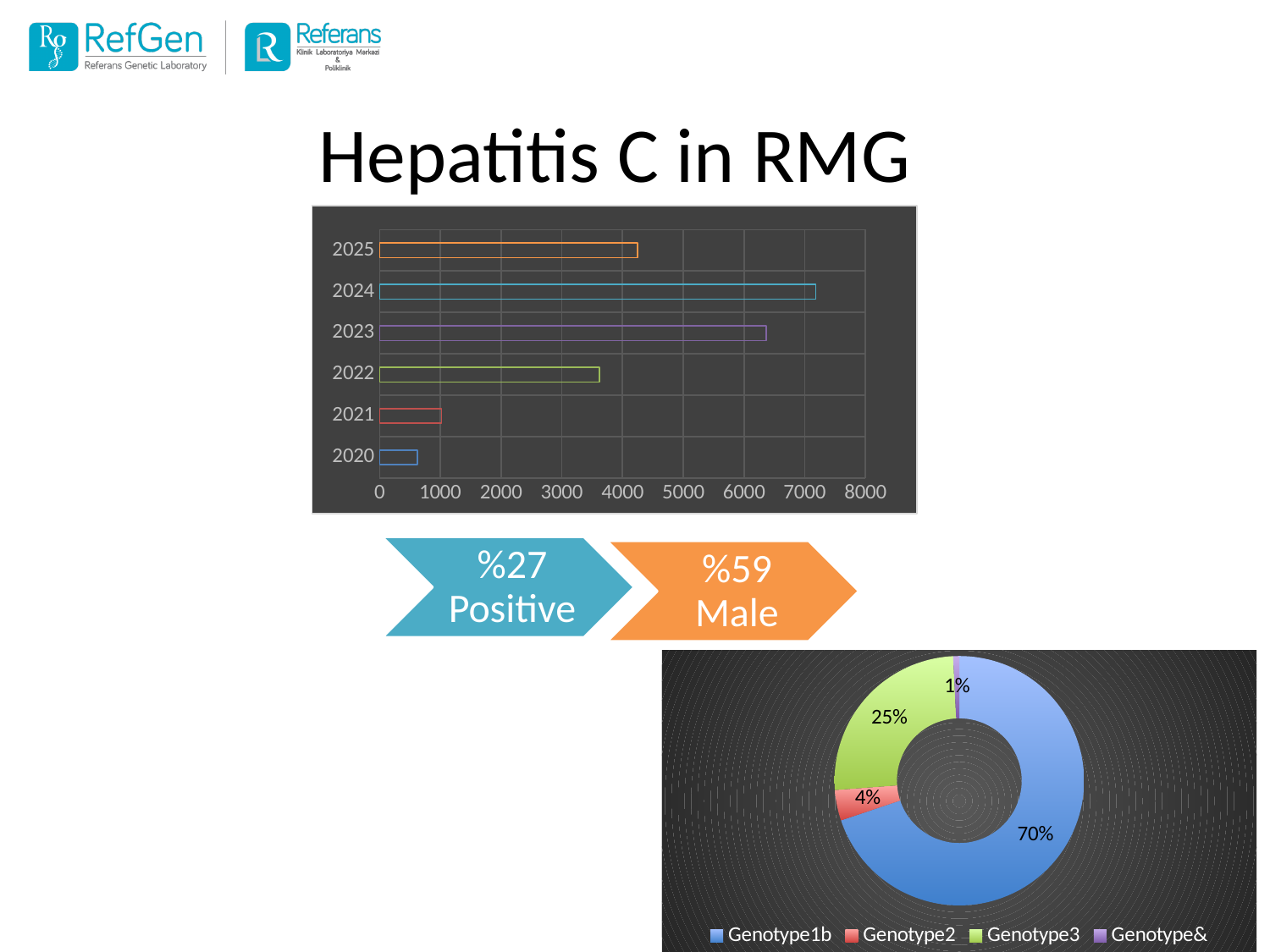
In the top bar chart, is the value for 2024 greater or less than 7000? greater In the bottom doughnut chart, what share does Genotype3 have? 25% In the top bar chart, which year has the larger value, 2025 or 2023? 2023 In the top bar chart, which year has the highest value? 2024 What kind of chart is the bottom chart on the slide? doughnut chart How many entries does the legend of the bottom doughnut chart list? 4 How many years are shown in the top bar chart? 6 What kind of chart is the top chart on the slide? bar chart In the top bar chart, is the value for 2022 greater or less than 4000? less In the top bar chart, which year has the lowest value? 2020 In the bottom doughnut chart, what share does Genotype1b have? 70% In the top bar chart, is the value for 2023 greater or less than 6000? greater